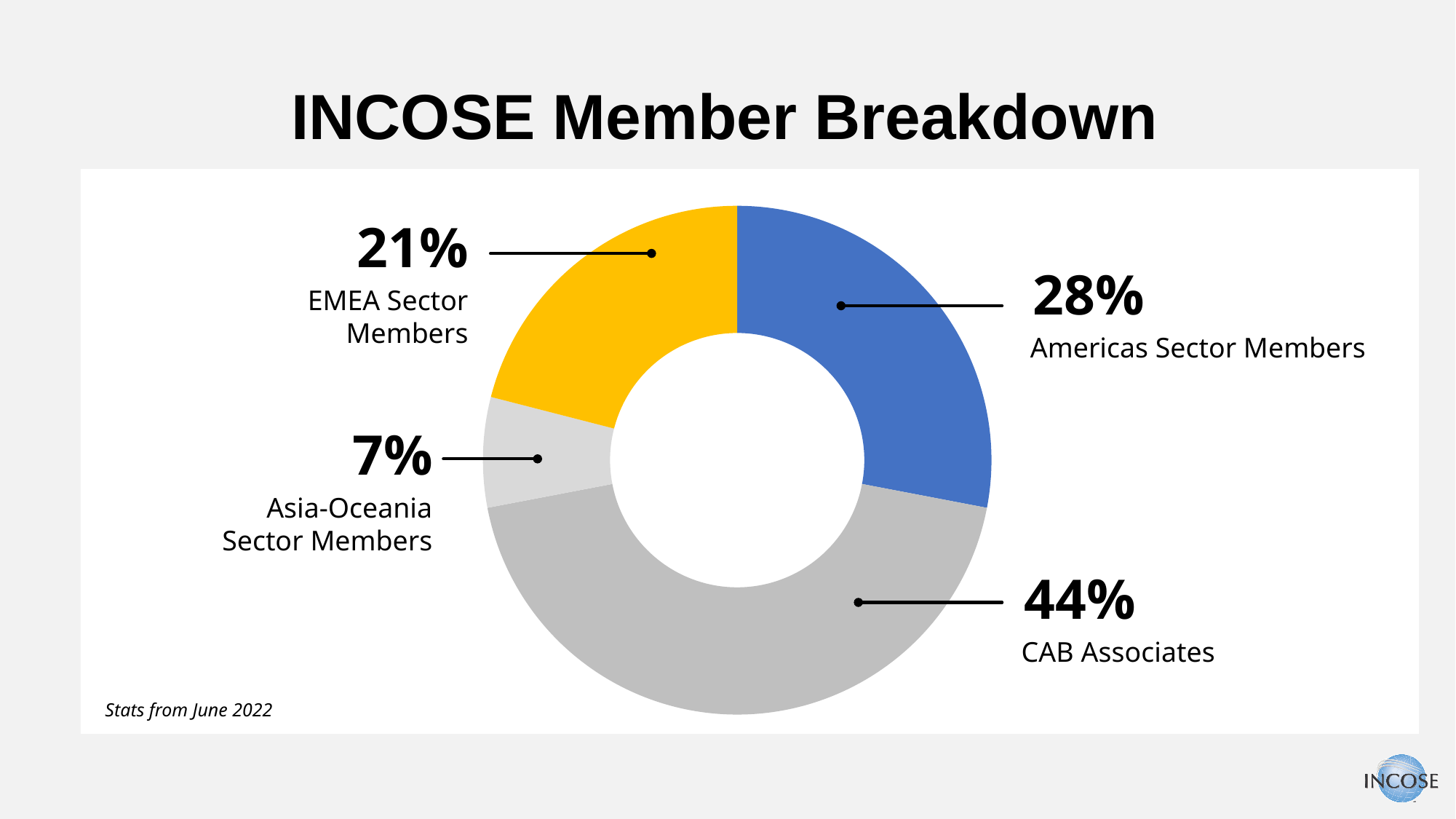
Which category has the largest share of INCOSE members? CAB Associates What percentage of INCOSE members are CAB Associates? 44% What kind of chart is shown on the slide? Pie chart (donut) How many categories are shown in the chart? 4 Which category has the smallest share of INCOSE members? Asia-Oceania Sector Members What percentage of INCOSE members are EMEA Sector Members? 21% What percentage of INCOSE members are Americas Sector Members? 28% What is the difference in percentage points between CAB Associates and Americas Sector Members? 16 What percentage of INCOSE members are Asia-Oceania Sector Members? 7% Which is larger, the share of Americas Sector Members or EMEA Sector Members? Americas Sector Members What is the title of the chart? INCOSE Member Breakdown What is the difference in percentage points between EMEA Sector Members and Asia-Oceania Sector Members? 14